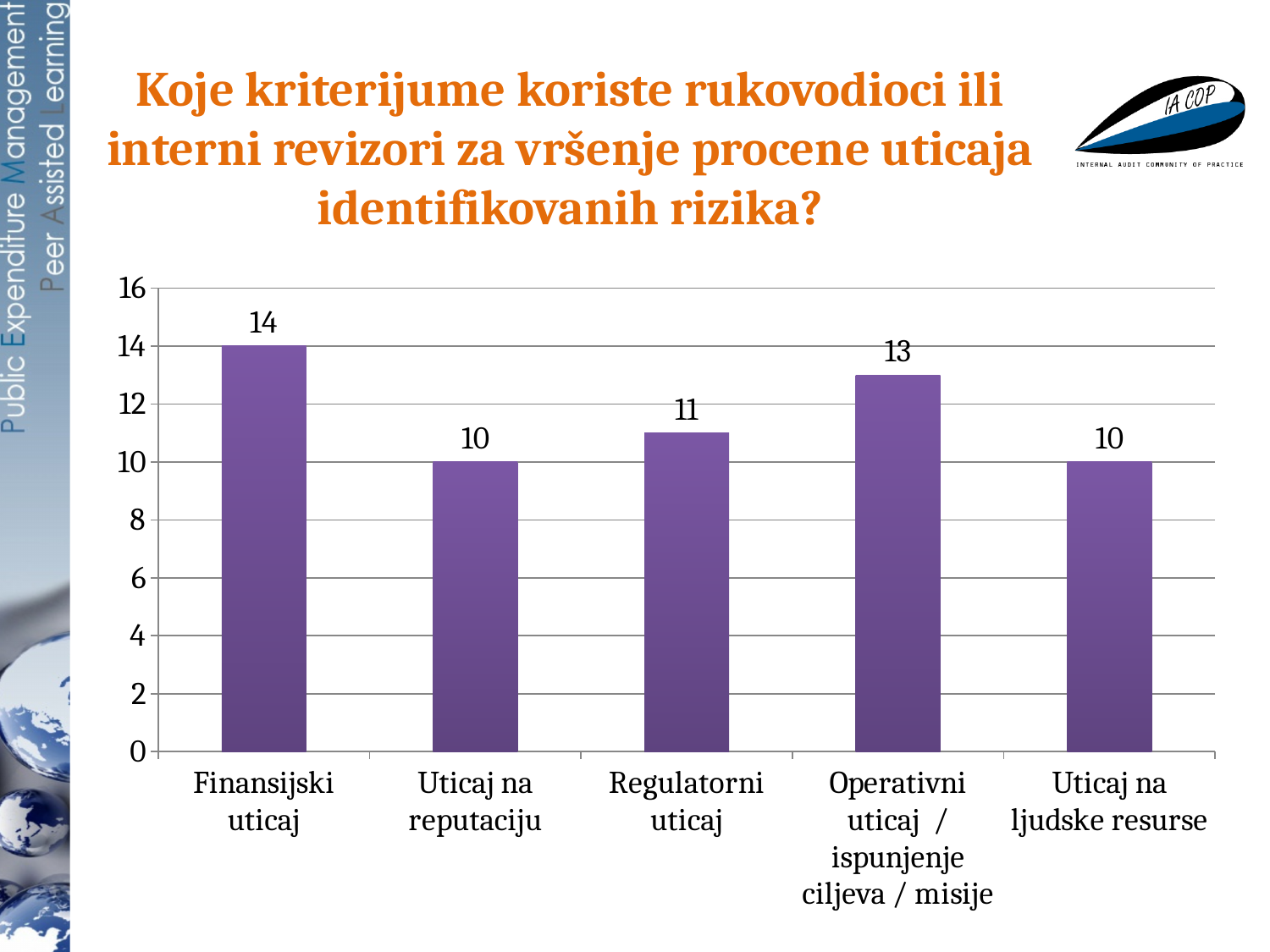
What is the value for Operativni uticaj / ispunjenje ciljeva / misije? 13 What is the value for Finansijski uticaj? 14 What is the difference between the values for Finansijski uticaj and Regulatorni uticaj? 3 Which category has the highest value? Finansijski uticaj Is the value for Finansijski uticaj greater or less than 12? greater What kind of chart is shown on the slide? bar chart What is the value for Uticaj na ljudske resurse? 10 Which is larger, the value for Operativni uticaj / ispunjenje ciljeva / misije or the value for Uticaj na reputaciju? Operativni uticaj / ispunjenje ciljeva / misije What is the value for Regulatorni uticaj? 11 Which two categories share the lowest value of 10? Uticaj na reputaciju and Uticaj na ljudske resurse How many categories are shown on the x axis? 5 What is the highest value shown on the vertical axis? 16